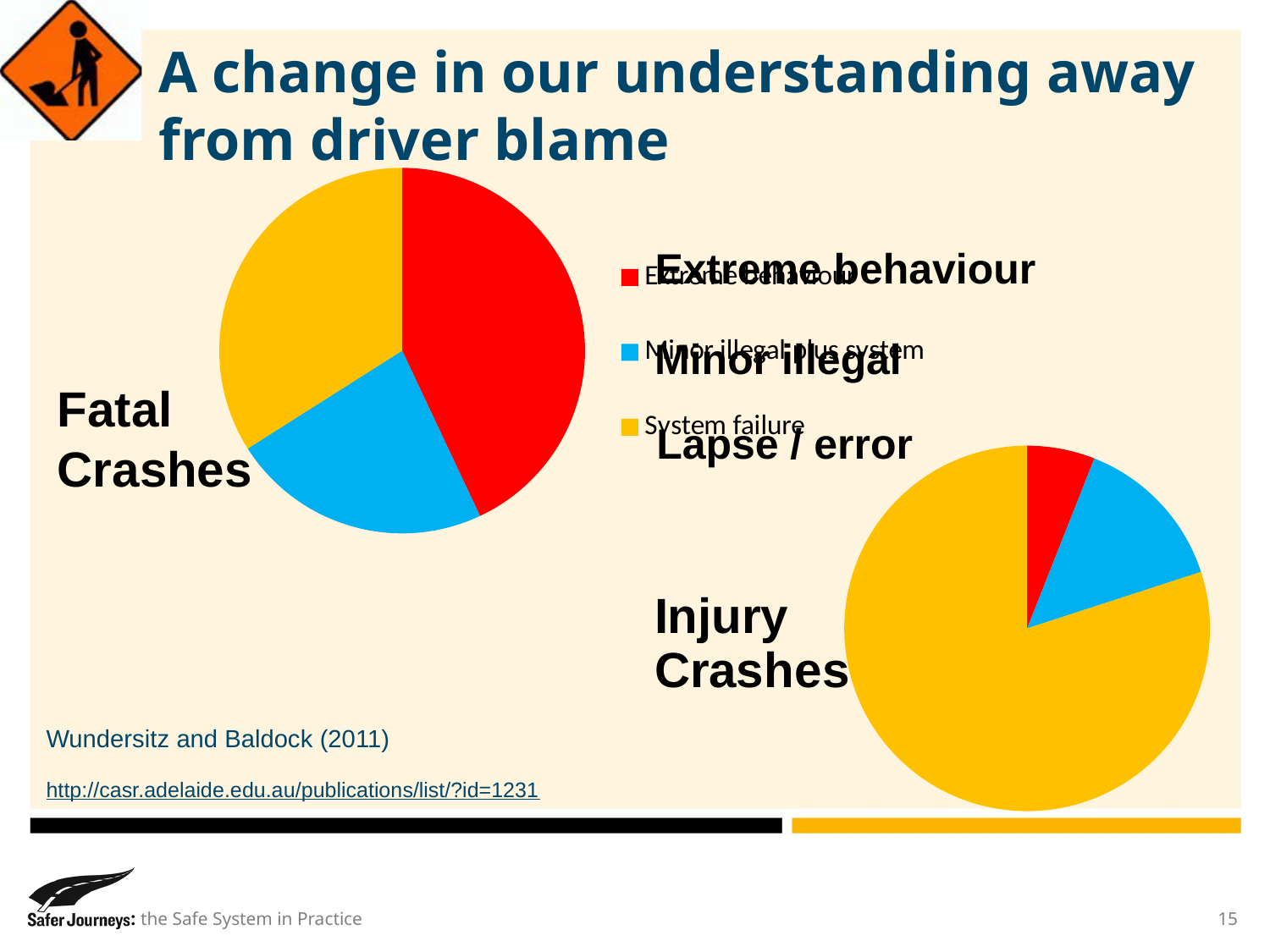
How many categories does the legend list? 3 What kind of charts are shown on the slide? Pie charts What colour represents Extreme behaviour in the pie charts? Red In the Injury Crashes pie chart, which slice is larger: Extreme behaviour or Minor illegal? Minor illegal In the Injury Crashes pie chart, which category has the smallest slice? Extreme behaviour In the Fatal Crashes pie chart, which slice is larger: Extreme behaviour or Minor illegal? Extreme behaviour How many pie charts are on the slide? 2 What is the title of the pie chart on the left of the slide? Fatal Crashes Which pie chart has the larger Lapse / error share: Fatal Crashes or Injury Crashes? Injury Crashes In the Injury Crashes pie chart, which category has the largest slice? Lapse / error In the Fatal Crashes pie chart, which category has the smallest slice? Minor illegal